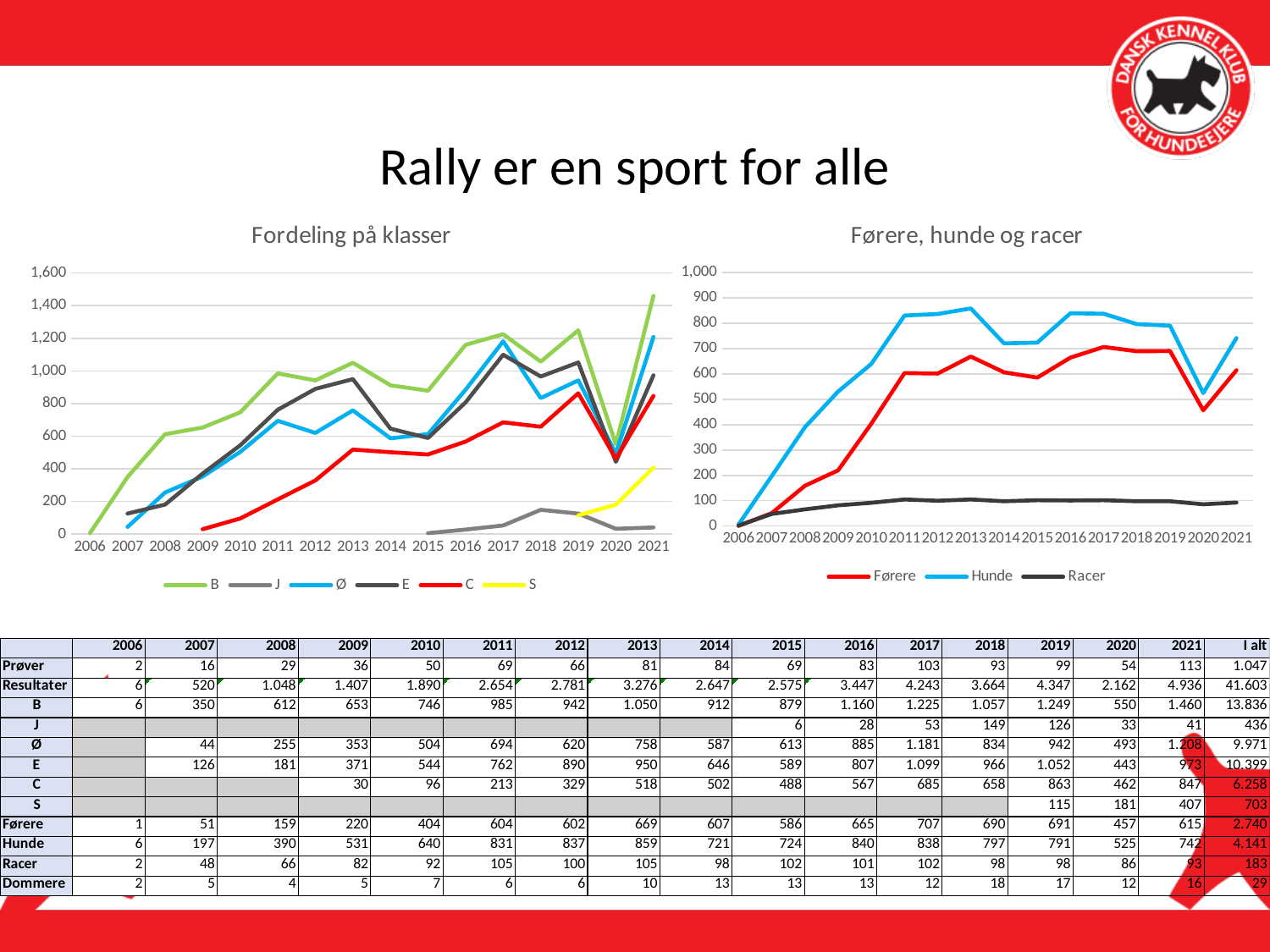
In "Fordeling på klasser", is the value for B in 2021 greater or less than 1,400? greater How many years are shown on the x axis of "Førere, hunde og racer"? 16 In "Førere, hunde og racer", what is the value of Hunde in 2013? 859 How many series does the legend of "Fordeling på klasser" list? 6 In "Førere, hunde og racer", what is the difference between Hunde and Førere in 2021? 127 In "Førere, hunde og racer", which series has the highest value in 2021? Hunde What kind of chart is "Fordeling på klasser"? line chart How many series does the legend of "Førere, hunde og racer" list? 3 In "Fordeling på klasser", which is larger in 2011: B or C? B In "Fordeling på klasser", what is the value of B in 2021? 1.460 In "Førere, hunde og racer", does the Hunde line rise or fall between 2006 and 2011? rise In "Fordeling på klasser", which series has the lowest value in 2021? J